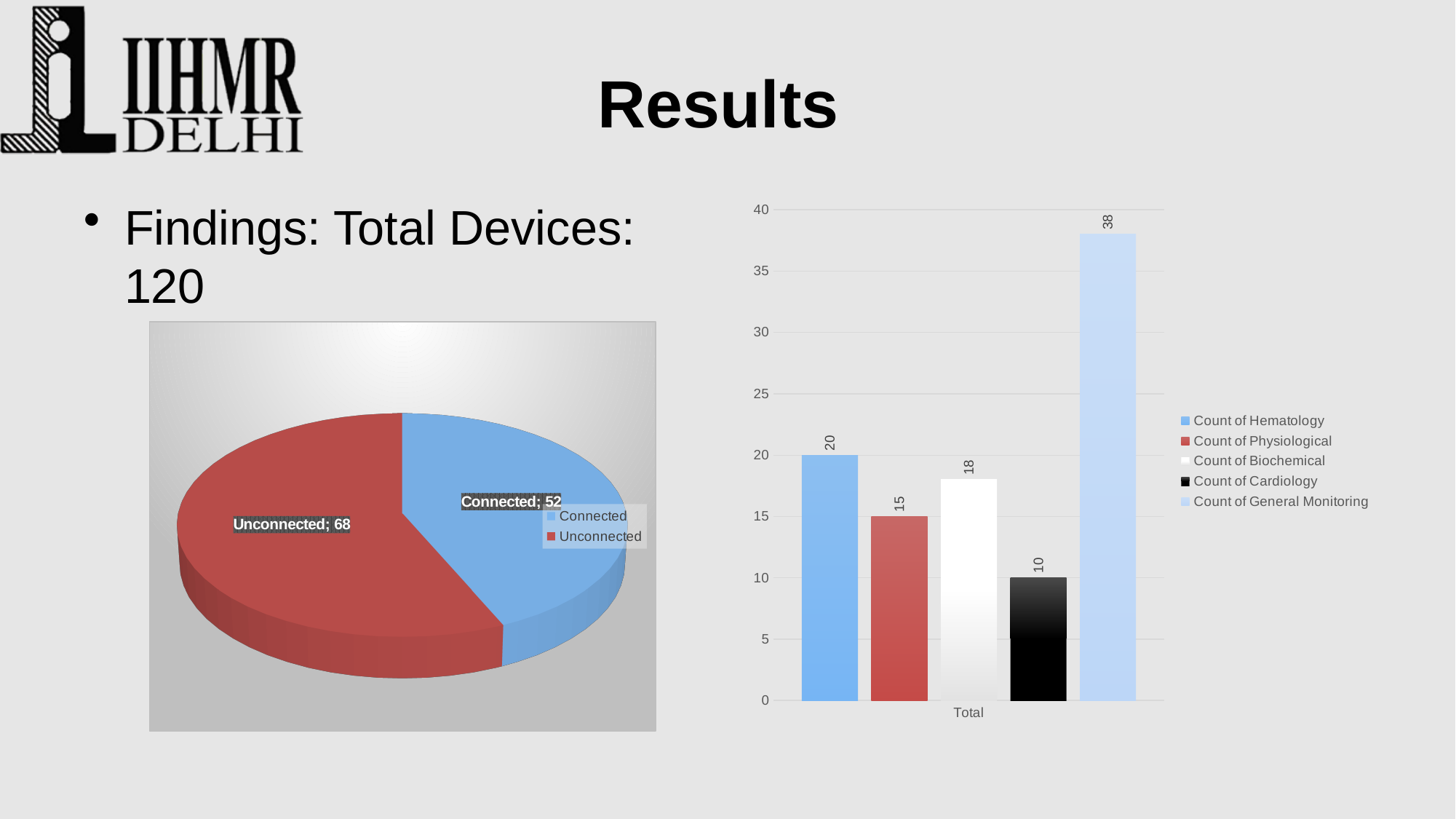
In the bar chart on the right, which series has the highest value? Count of General Monitoring What type of chart is shown on the left of the slide? Pie chart In the pie chart on the left, how many devices are Connected? 52 In the bar chart on the right, what is the difference between Count of Hematology and Count of Physiological? 5 In the pie chart on the left, what is the difference between the Unconnected and Connected counts? 16 In the bar chart on the right, what is the value for Count of General Monitoring? 38 How many series does the legend of the bar chart on the right list? 5 In the pie chart on the left, how many devices are Unconnected? 68 In the pie chart on the left, which slice is larger, Connected or Unconnected? Unconnected In the bar chart on the right, which series has the lowest value? Count of Cardiology In the bar chart on the right, what is the value for Count of Cardiology? 10 In the pie chart on the left, how many slices are there? 2